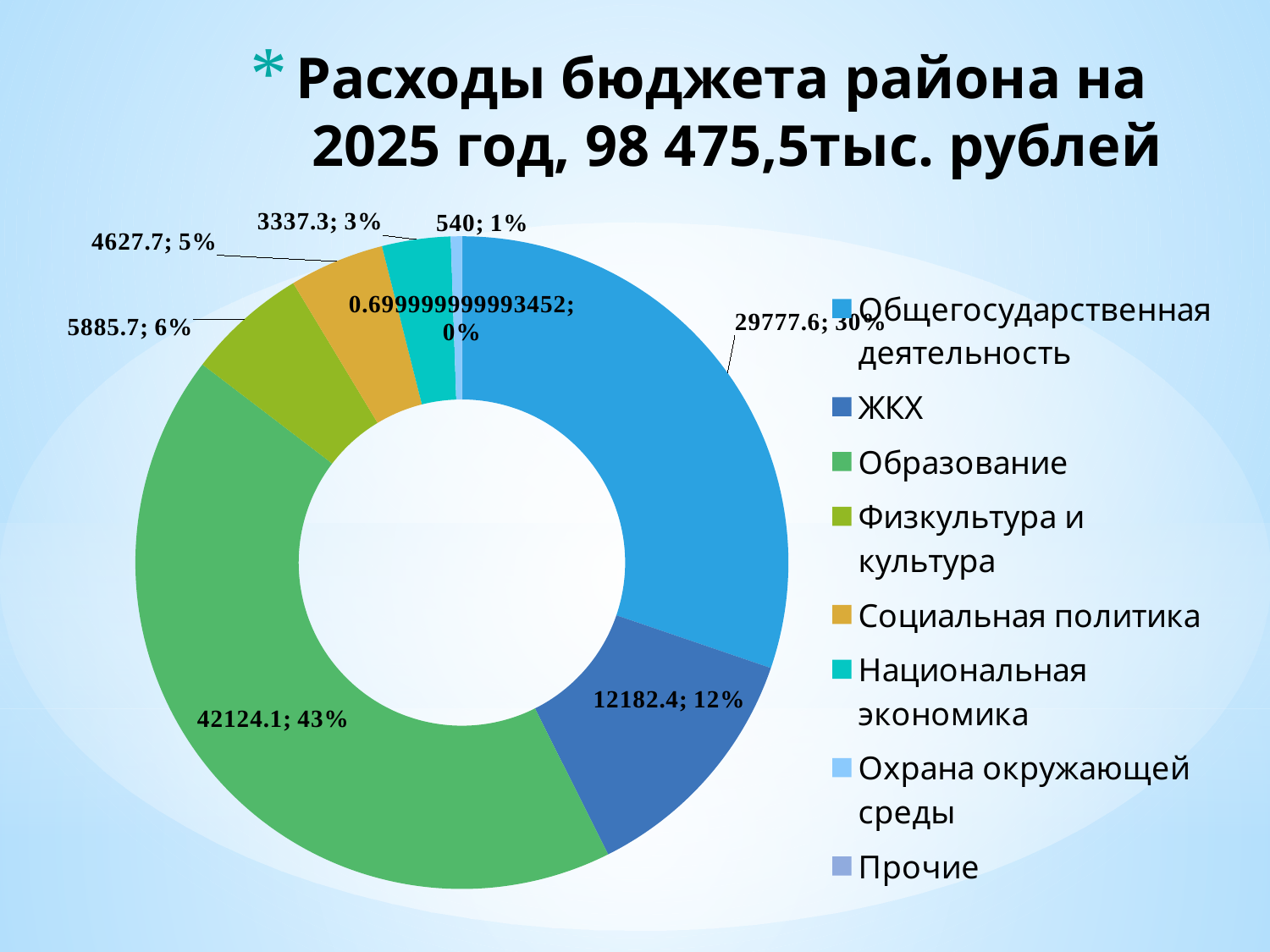
What share of the chart does Социальная политика take? 5% What share of the chart does Общегосударственная деятельность take? 30% Which category has the largest slice? Образование What value is shown for Образование? 42124.1 What value is shown for Национальная экономика? 3337.3 What is the difference between the values for Образование and Общегосударственная деятельность? 12346.5 What is the title of the chart? Расходы бюджета района на 2025 год, 98 475,5тыс. рублей What value is shown for ЖКХ? 12182.4 Which is larger, the value for ЖКХ or the value for Физкультура и культура? ЖКХ What kind of chart is shown on the slide? doughnut (pie) chart Which category has the smallest slice? Прочие How many categories does the legend list? 8